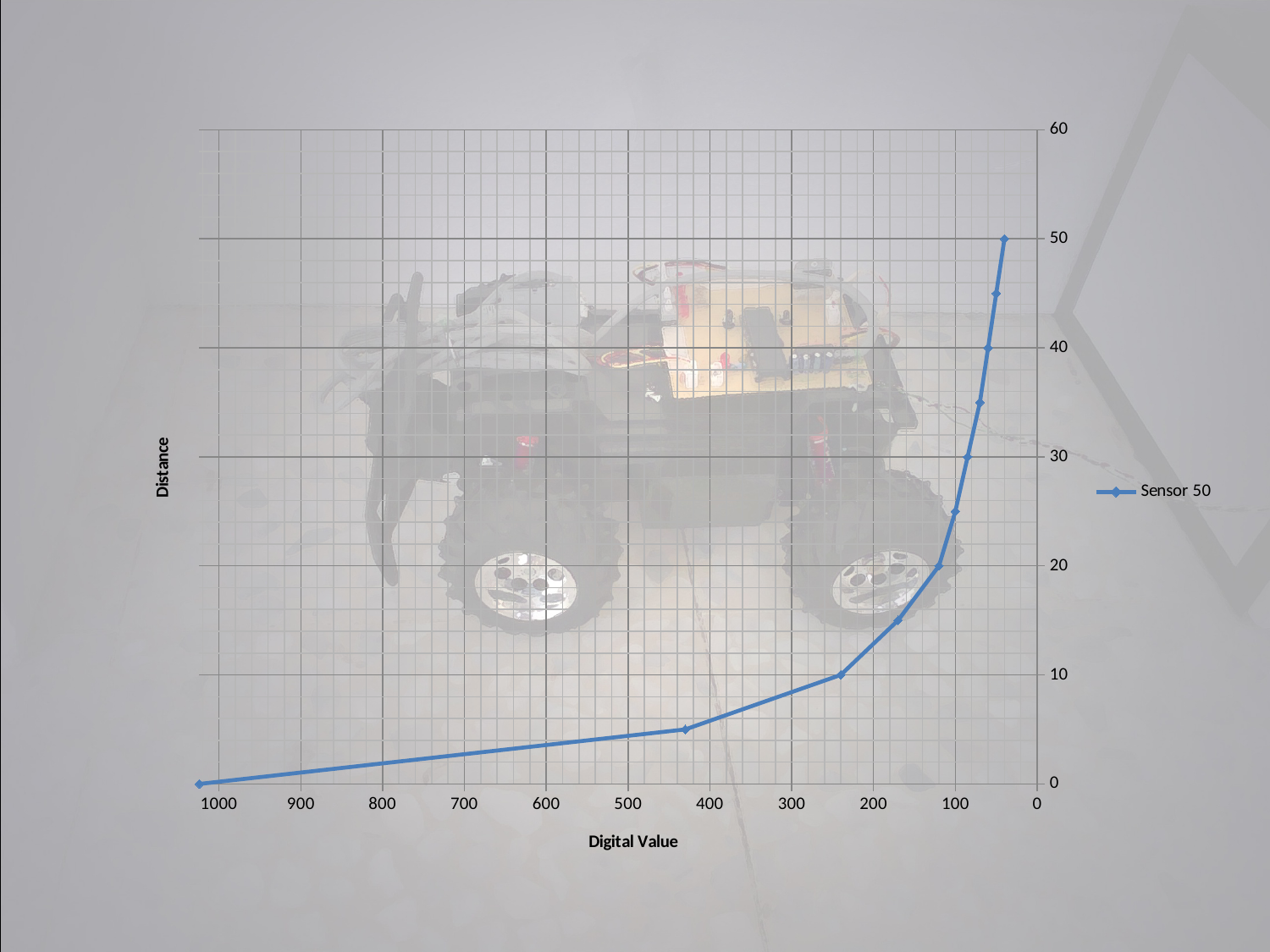
Moving from left to right along the Digital Value axis, does the Sensor 50 line rise or fall? rise Is the Distance at a Digital Value of 1000 greater or less than 10? less Is the Distance at a Digital Value of 400 greater or less than 10? less What kind of chart is shown on the slide? line chart What is the name of the series shown in the legend? Sensor 50 Is the Distance at a Digital Value of 100 greater or less than 20? greater What is the highest Distance value reached by the Sensor 50 line? 50 What is the title of the horizontal axis? Digital Value What is the lowest Distance value on the Sensor 50 line? 0 How many series does the legend list? 1 How many data points are plotted on the Sensor 50 line? 11